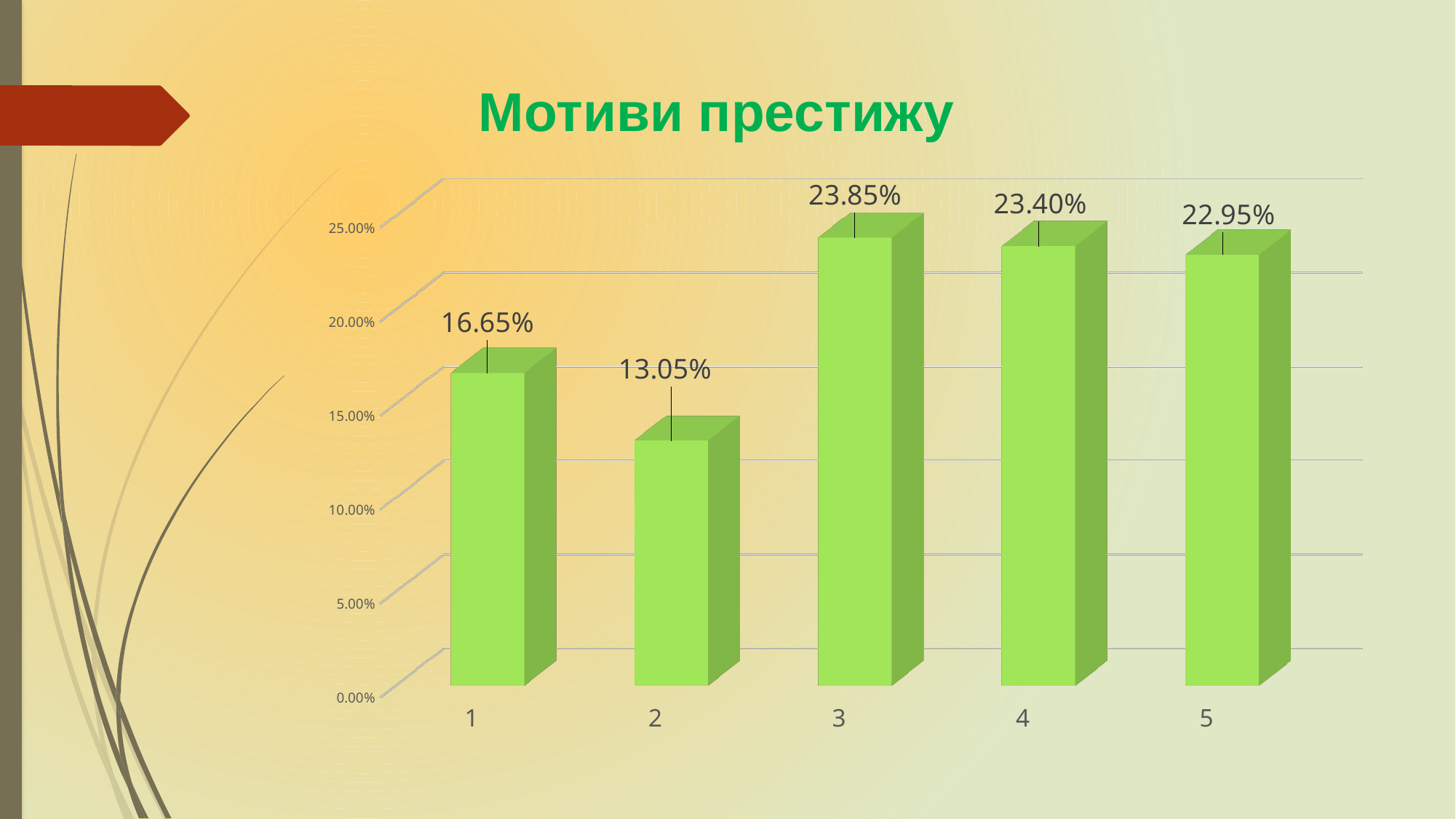
What is the difference between the values for category 1 and category 2? 3.60% What is the value for category 5? 22.95% What kind of chart is shown on the slide? bar chart What is the value for category 2? 13.05% Which category has the highest value? 3 What is the value for category 3? 23.85% Which category has the lowest value? 2 How many categories are shown on the x axis? 5 What is the value for category 1? 16.65% Which is larger, the value for category 1 or the value for category 4? 4 What is the difference between the values for category 3 and category 2? 10.80% Is the value for category 2 greater or less than 15.00%? less